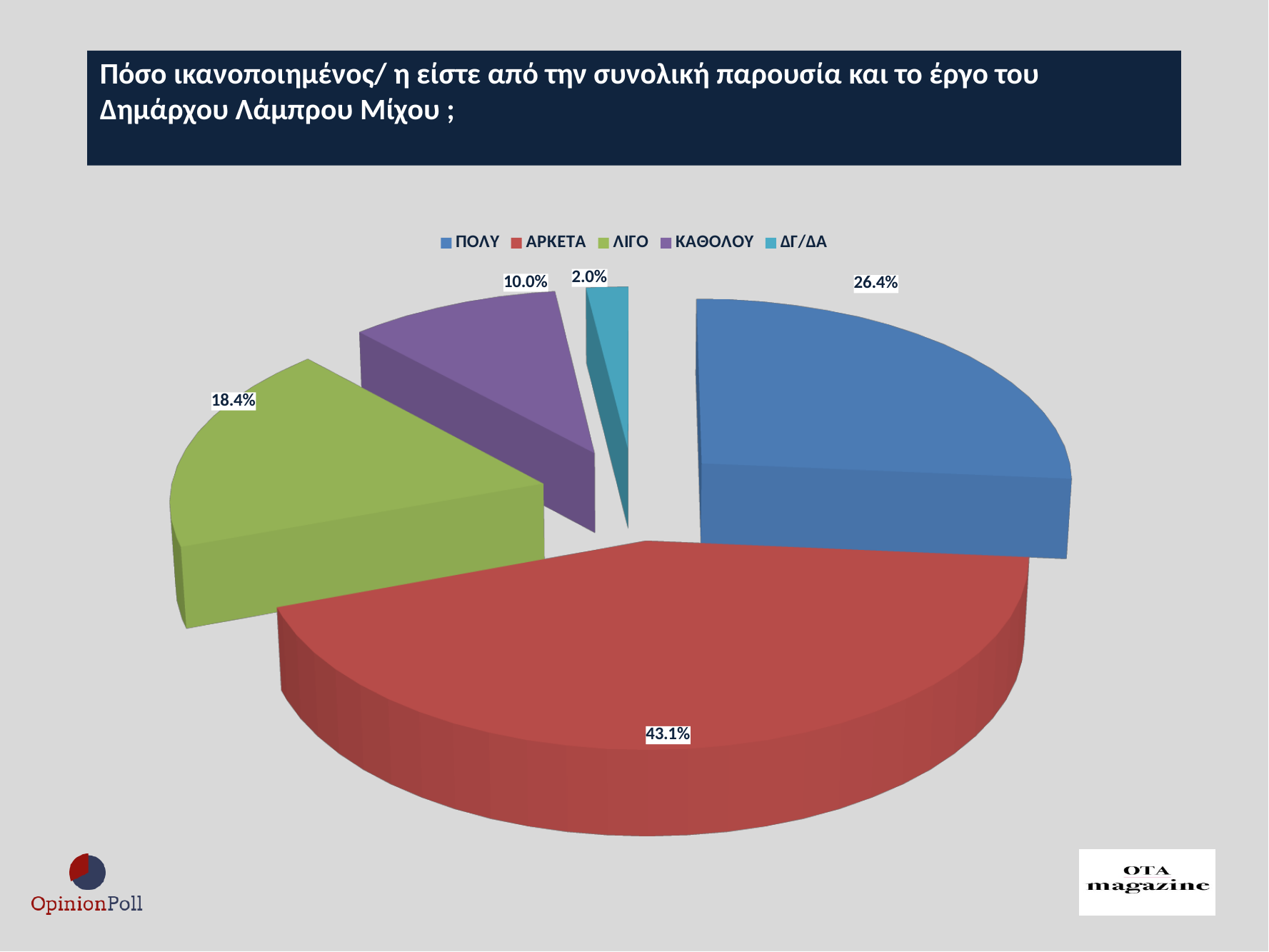
What percentage of respondents answered ΛΙΓΟ? 18.4% What percentage of respondents answered ΑΡΚΕΤΑ? 43.1% What percentage of respondents answered ΠΟΛΥ? 26.4% What kind of chart is shown on the slide? Pie chart What percentage of respondents answered ΚΑΘΟΛΟΥ? 10.0% How many categories does the legend list? 5 What percentage of respondents answered ΔΓ/ΔΑ? 2.0% Which response category has the smallest share of the pie? ΔΓ/ΔΑ What colour is the slice for ΠΟΛΥ? Blue Which response category has the largest share of the pie? ΑΡΚΕΤΑ What is the difference in percentage points between ΑΡΚΕΤΑ and ΠΟΛΥ? 16.7 Which is larger, the share for ΛΙΓΟ or the share for ΚΑΘΟΛΟΥ? ΛΙΓΟ